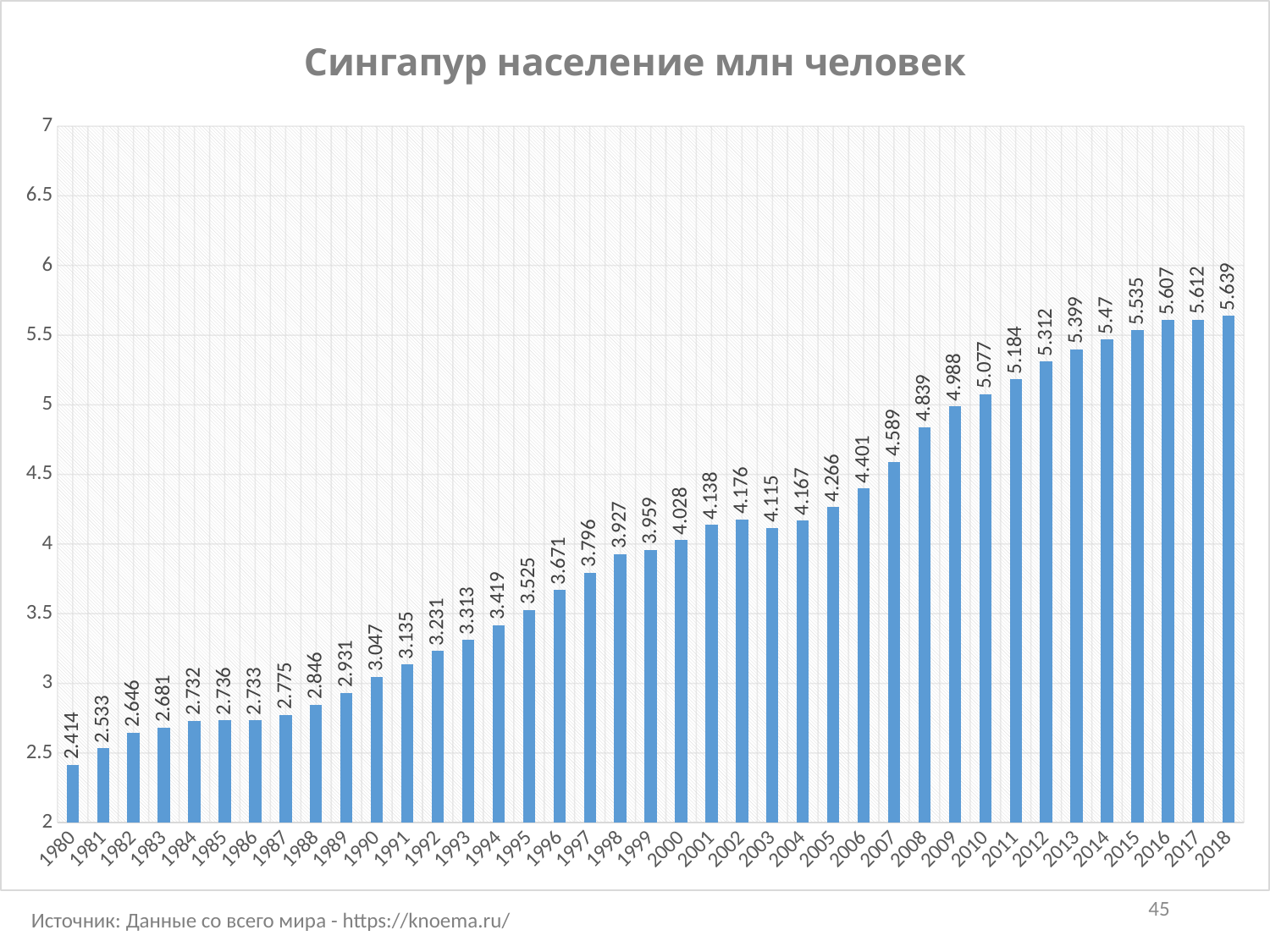
Which is larger, the value for 2003 or the value for 2004? 2004 How many years are shown on the x axis? 39 What was Singapore's population in 1990 according to the chart? 3.047 Is the value for 2010 greater or less than 5? greater Do the values generally rise or fall from 1980 to 2018? Rise What value is shown for 2018? 5.639 Which year has the lowest population value on the chart? 1980 What value is shown for 2008? 4.839 What is the title of the chart? Сингапур население млн человек What kind of chart is shown on the slide? Bar chart What is the difference between the 2018 value and the 1980 value? 3.225 Which year has the highest population value on the chart? 2018